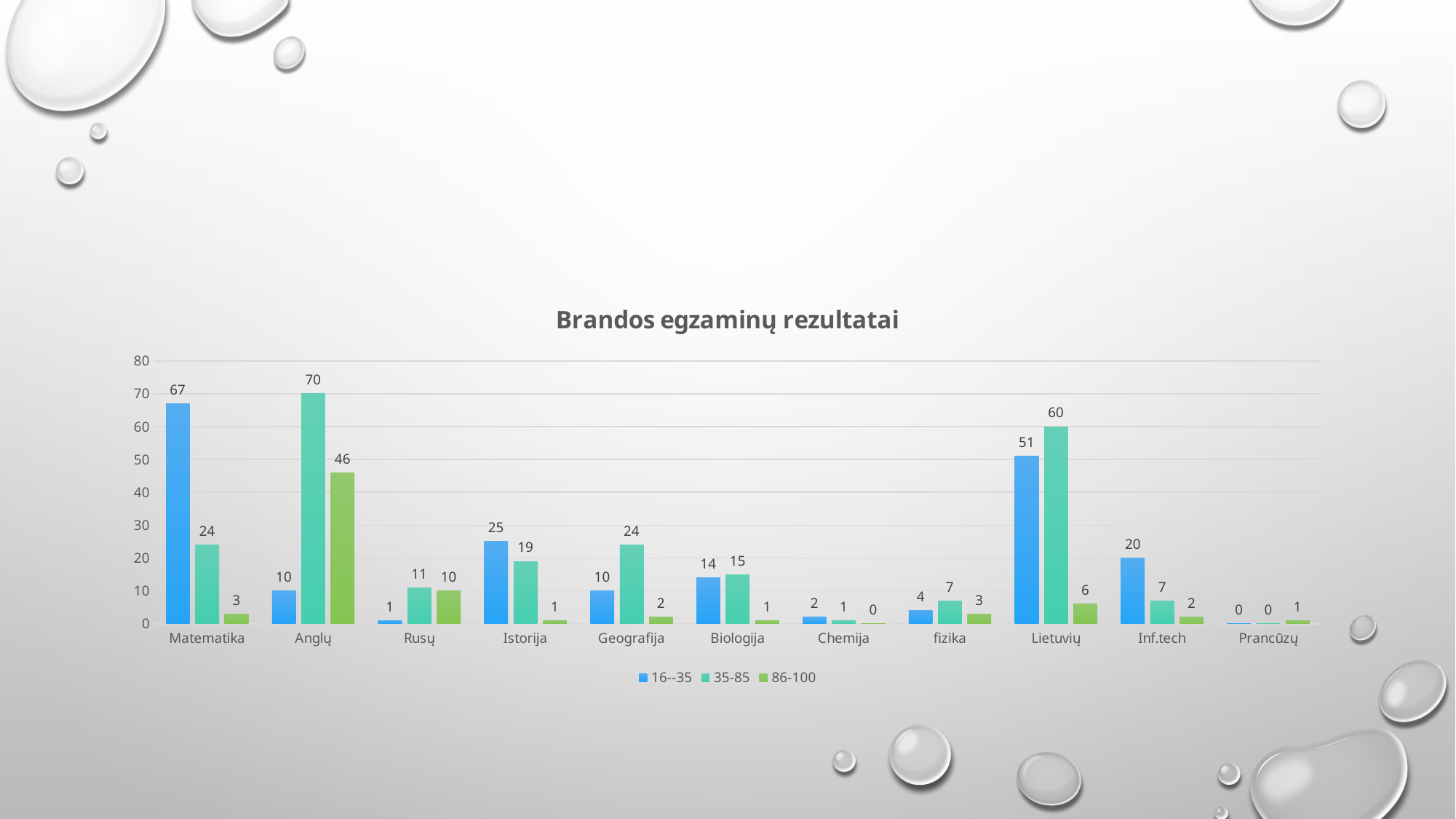
What is the total of the three series values for Inf.tech? 29 Which is larger for Istorija: the 16--35 value or the 35-85 value? 16--35 Which category has the highest value in the 35-85 series? Anglų How many series does the legend list? 3 What is the value for Lietuvių in the 35-85 series? 60 Which category has the lowest value in the 16--35 series? Prancūzų What is the title of the chart? Brandos egzaminų rezultatai What is the difference between the 16--35 and 35-85 values for Matematika? 43 How many categories are shown on the x axis? 11 What kind of chart is shown on the slide? bar chart What is the value for Anglų in the 86-100 series? 46 What is the value for Matematika in the 16--35 series? 67